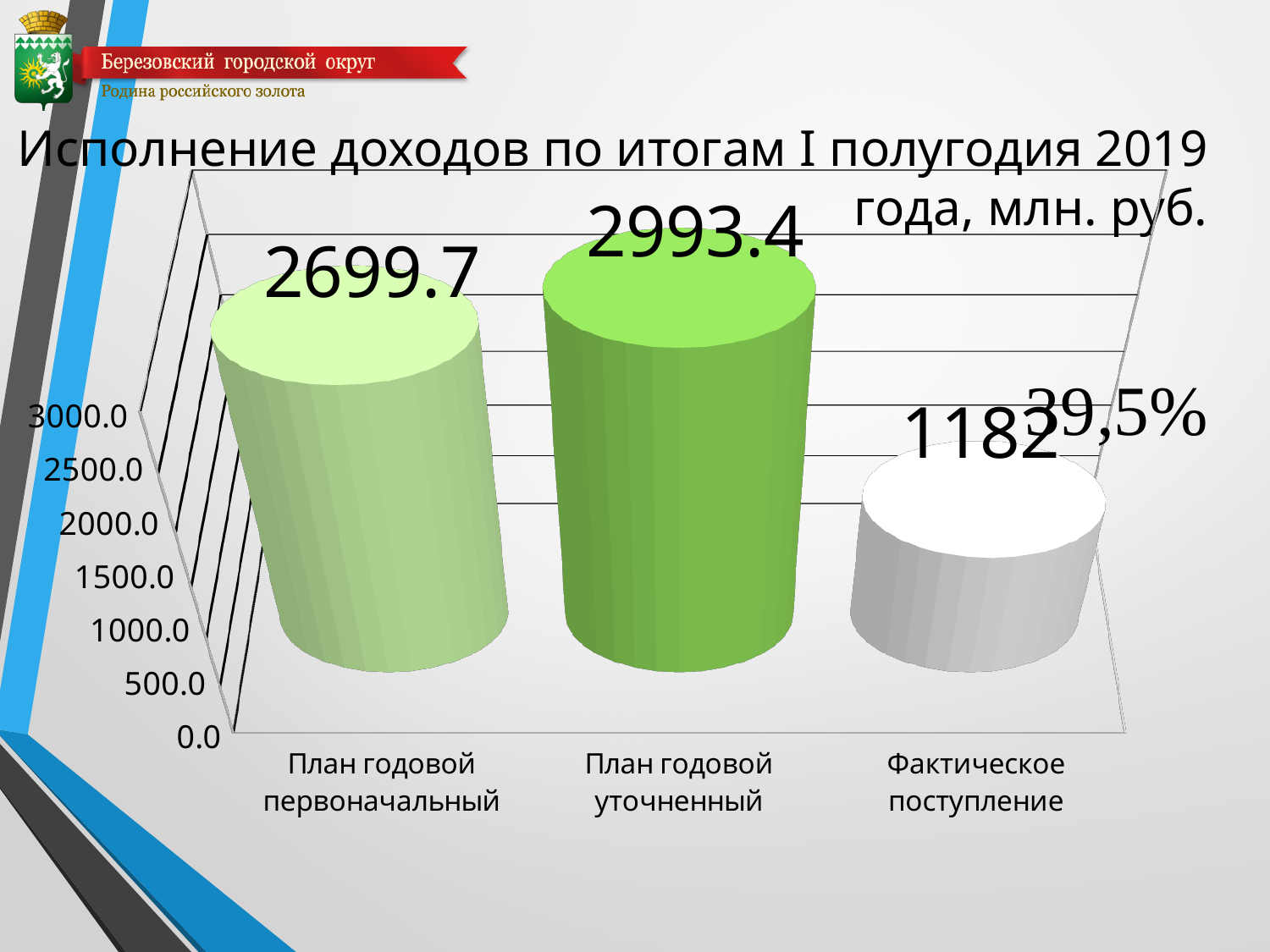
Which category has the lowest value? Фактическое поступление Which is larger, План годовой первоначальный or План годовой уточненный? План годовой уточненный Is the value for План годовой первоначальный greater or less than 2500? greater Is the value for Фактическое поступление greater or less than 1500? less Which category has the highest value? План годовой уточненный What kind of chart is shown on the slide? bar chart What percentage is printed next to the Фактическое поступление bar? 39,5% How many categories are shown on the chart? 3 What is the difference between План годовой уточненный and План годовой первоначальный? 293.7 What is the title of the chart? Исполнение доходов по итогам I полугодия 2019 года, млн. руб. What is the value for План годовой первоначальный? 2699.7 What is the value for План годовой уточненный? 2993.4